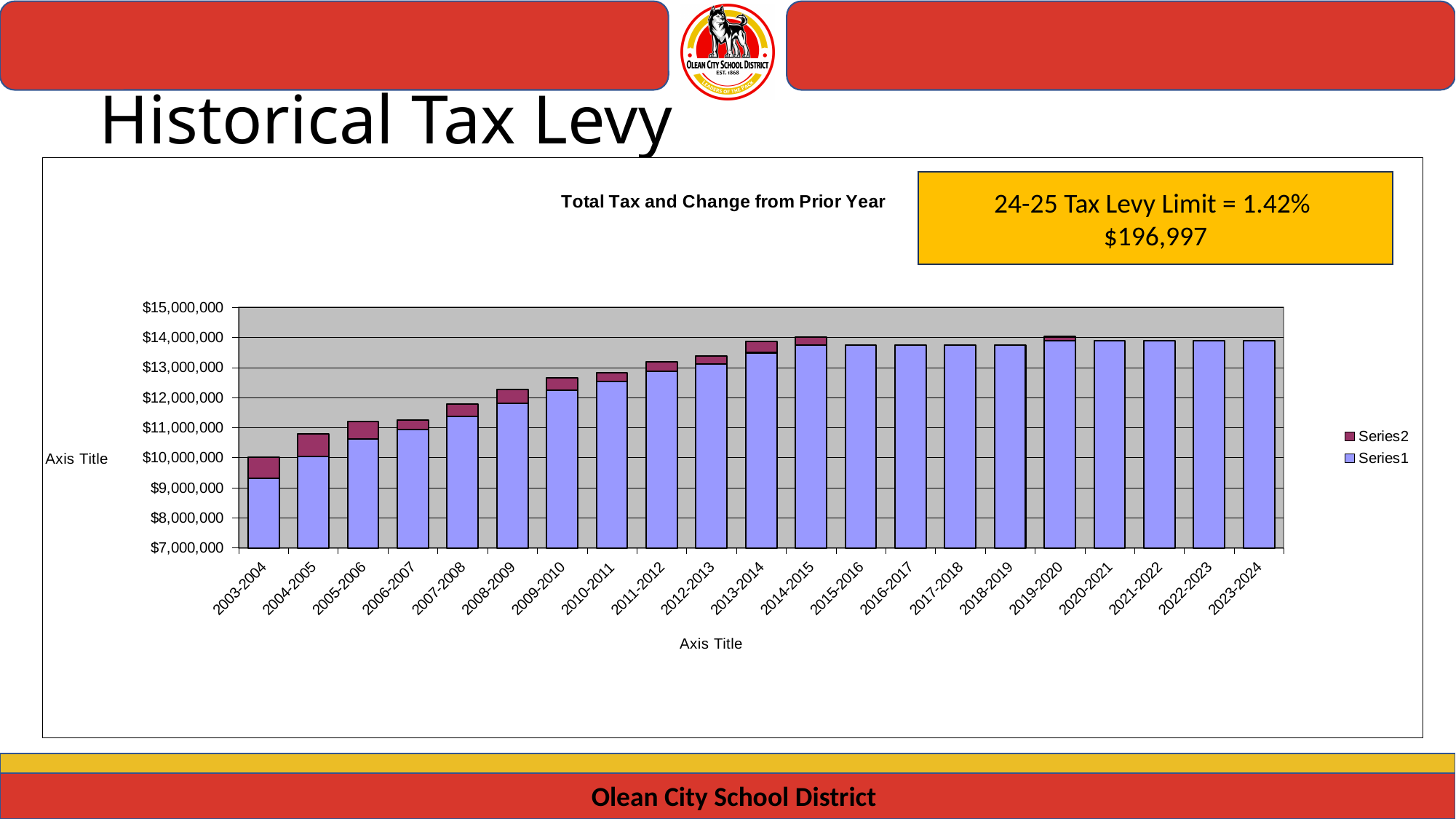
Is the Series1 value for 2003-2004 greater or less than $10,000,000? less Which school year has the lowest Series1 value? 2003-2004 What kind of chart is shown on the slide? Stacked bar chart What are the two entries listed in the chart legend? Series2 and Series1 Is the Series1 value for 2005-2006 greater or less than $11,000,000? less What is the title of the chart? Total Tax and Change from Prior Year Which is larger, the Series1 value for 2003-2004 or for 2004-2005? 2004-2005 Is the Series1 value for 2008-2009 greater or less than $11,000,000? greater How many series does the chart legend list? 2 Do the Series1 values generally rise or fall from 2003-2004 to 2023-2024? rise How many school years are shown along the x axis of the chart? 21